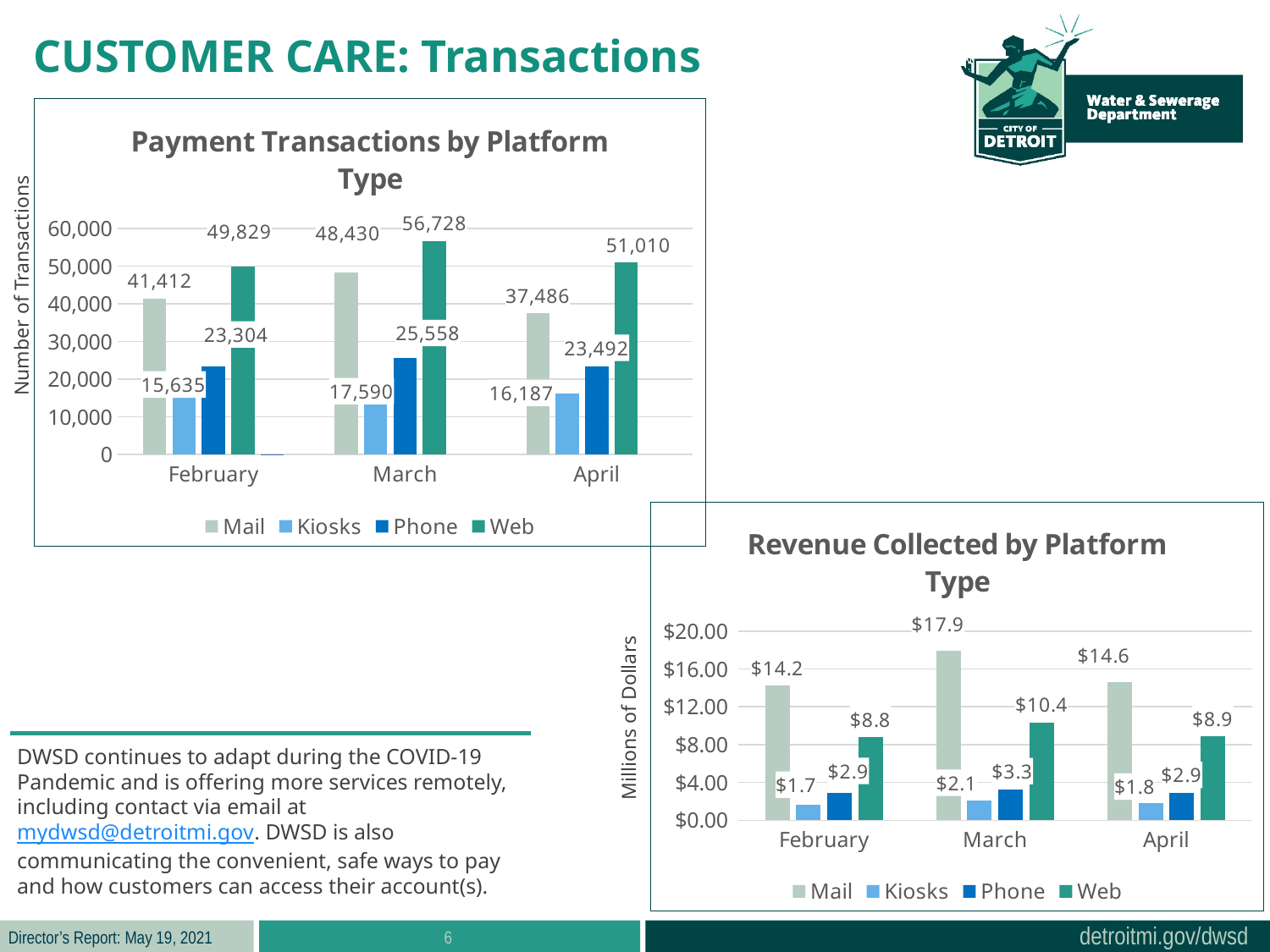
In the 'Payment Transactions by Platform Type' chart, which platform had the fewest transactions in April? Kiosks In the 'Revenue Collected by Platform Type' chart, is Web revenue in March greater or less than Web revenue in April? greater In the 'Revenue Collected by Platform Type' chart, what is the difference between Mail revenue in March and Mail revenue in February? $3.7 In the 'Revenue Collected by Platform Type' chart, which platform collected the most revenue in February? Mail In the 'Payment Transactions by Platform Type' chart, what is the difference between Web and Mail transactions in April? 13,524 What type of chart is the 'Revenue Collected by Platform Type' chart? Bar chart In the 'Payment Transactions by Platform Type' chart, how many series does the legend list? 4 In the 'Payment Transactions by Platform Type' chart, how many Web transactions were there in March? 56,728 In the 'Revenue Collected by Platform Type' chart, how much revenue was collected by Mail in March? $17.9 In the 'Payment Transactions by Platform Type' chart, how many Kiosks transactions were there in February? 15,635 In the 'Payment Transactions by Platform Type' chart, which month had the highest number of Mail transactions? March In the 'Revenue Collected by Platform Type' chart, how much revenue was collected via Phone in April? $2.9